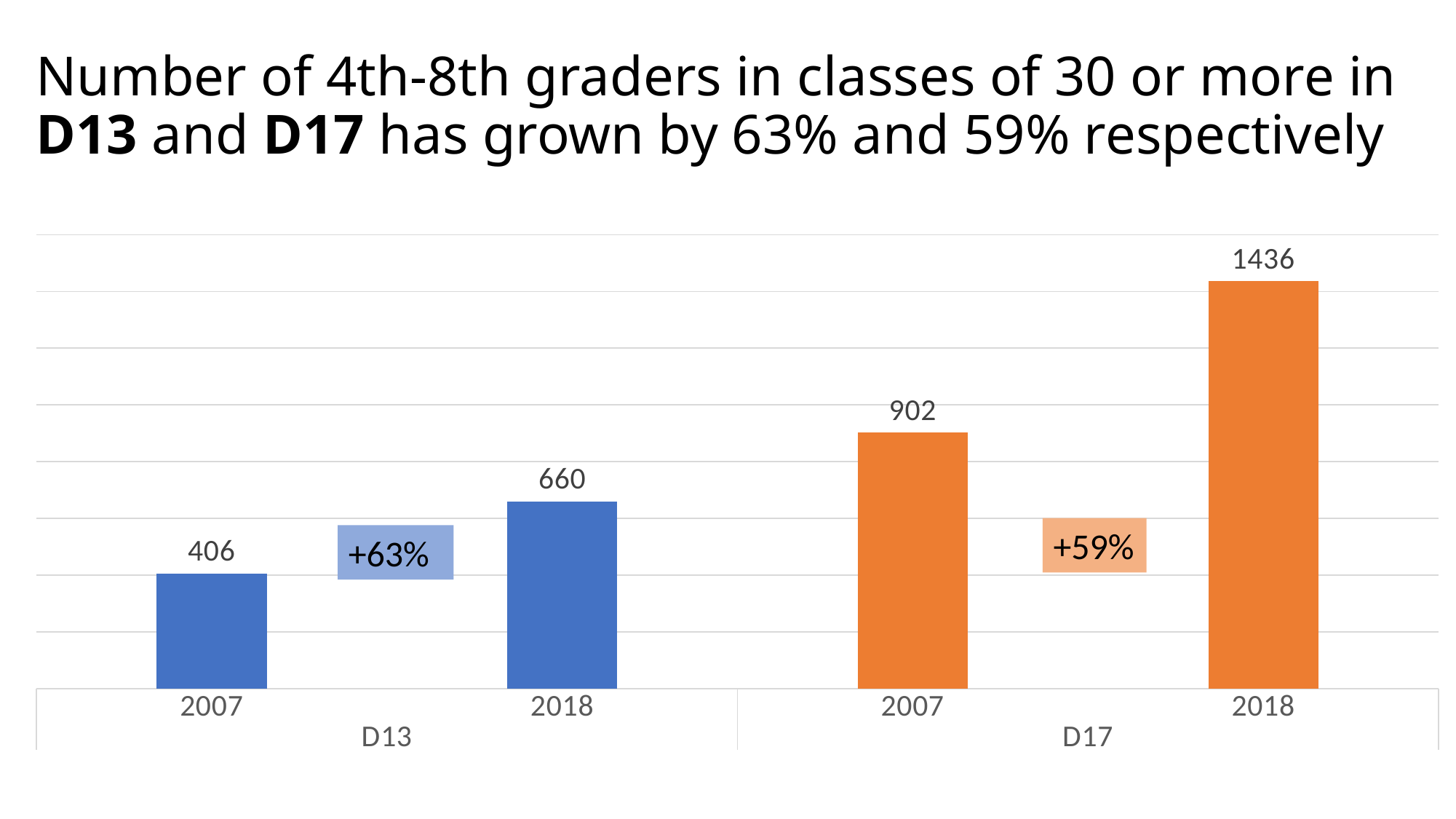
Which is larger, the D13 value for 2018 or the D17 value for 2007? D17 2007 What is the difference between the D17 values for 2018 and 2007? 534 What kind of chart is shown? Bar chart What is the value for D13 in 2007? 406 Which bar has the highest value? D17 2018 Which bar has the lowest value? D13 2007 What is the value for D17 in 2018? 1436 How many bars are plotted on the chart? 4 What is the value for D17 in 2007? 902 What percentage growth is labelled between the two D17 bars? +59% What is the difference between the D13 values for 2018 and 2007? 254 What is the value for D13 in 2018? 660